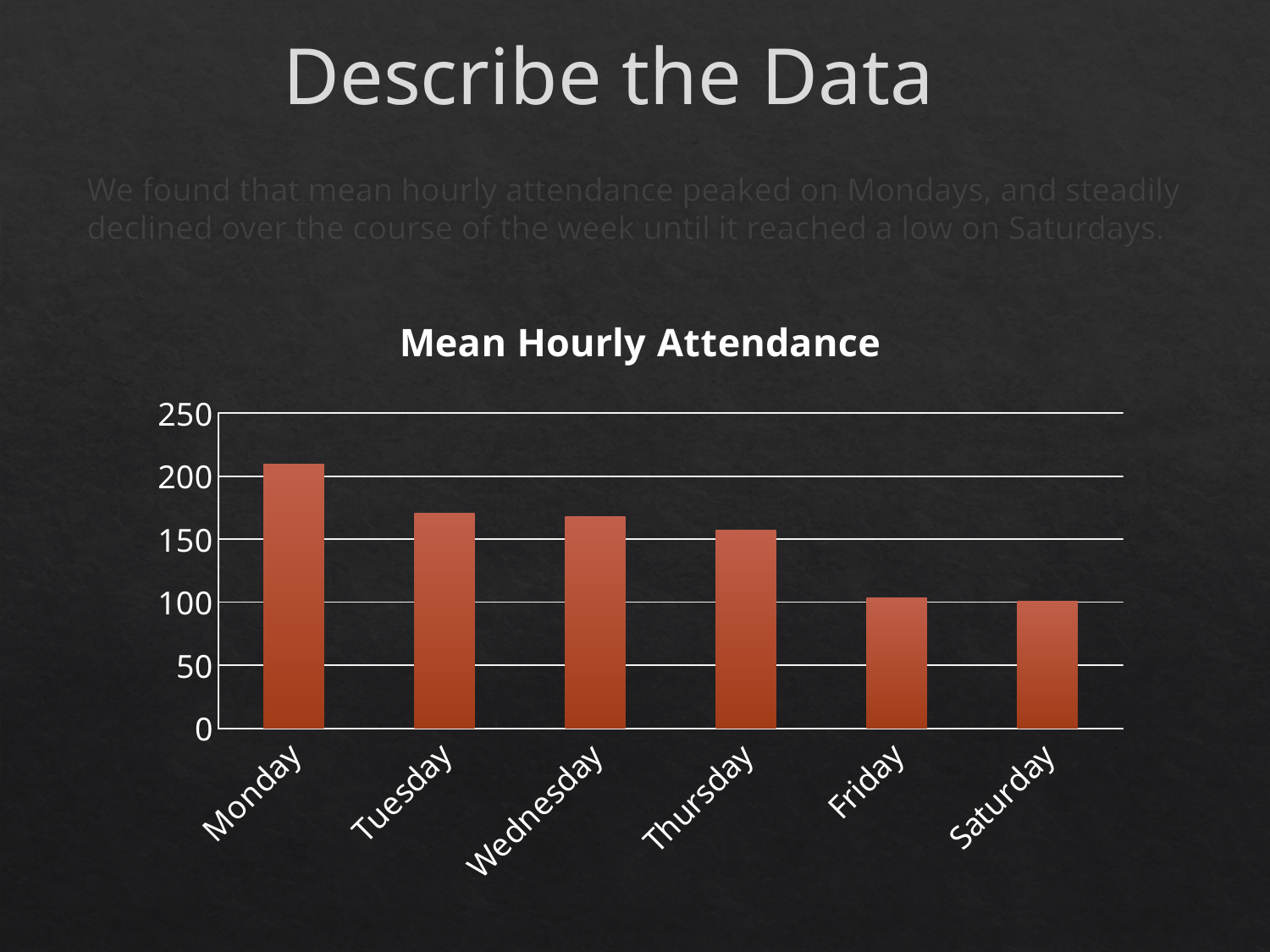
How many days are shown on the x axis of the chart? 6 Which is larger, the value for Thursday or the value for Friday? Thursday Is the value for Friday greater or less than 150? less Which day has the highest mean hourly attendance? Monday Is the value for Saturday greater or less than 150? less Is the value for Monday greater or less than 200? greater What type of chart is shown on the slide? bar chart Do the values rise or fall from Monday to Saturday? fall Which is larger, the value for Monday or the value for Tuesday? Monday What is the title of the chart? Mean Hourly Attendance